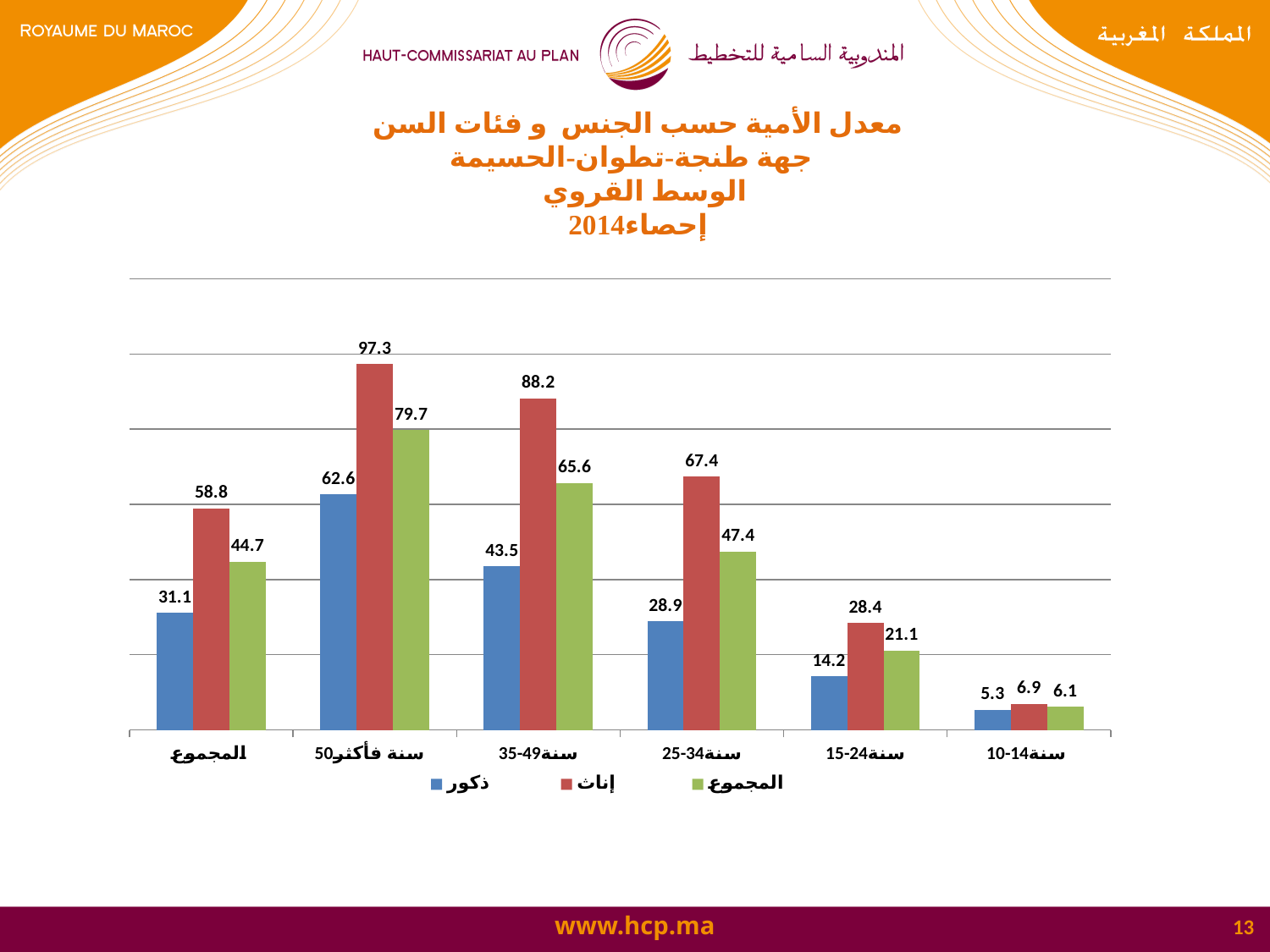
Which colour represents the إناث series? red What is the value for المجموع (series) in the 25-34 سنة category? 47.4 Which age category has the highest value for إناث? 50 سنة فأكثر What kind of chart is shown on the slide? bar chart Which age category has the lowest value for ذكور? 10-14 سنة How many series does the legend list? 3 What is the difference between the إناث and ذكور values in the 15-24 سنة category? 14.2 What is the value for ذكور in the 35-49 سنة category? 43.5 What is the value for إناث in the 50 سنة فأكثر category? 97.3 Which is larger in the 35-49 سنة category: the value for إناث or the value for ذكور? إناث How many categories are shown on the x axis? 6 What is the value for ذكور in the المجموع category? 31.1